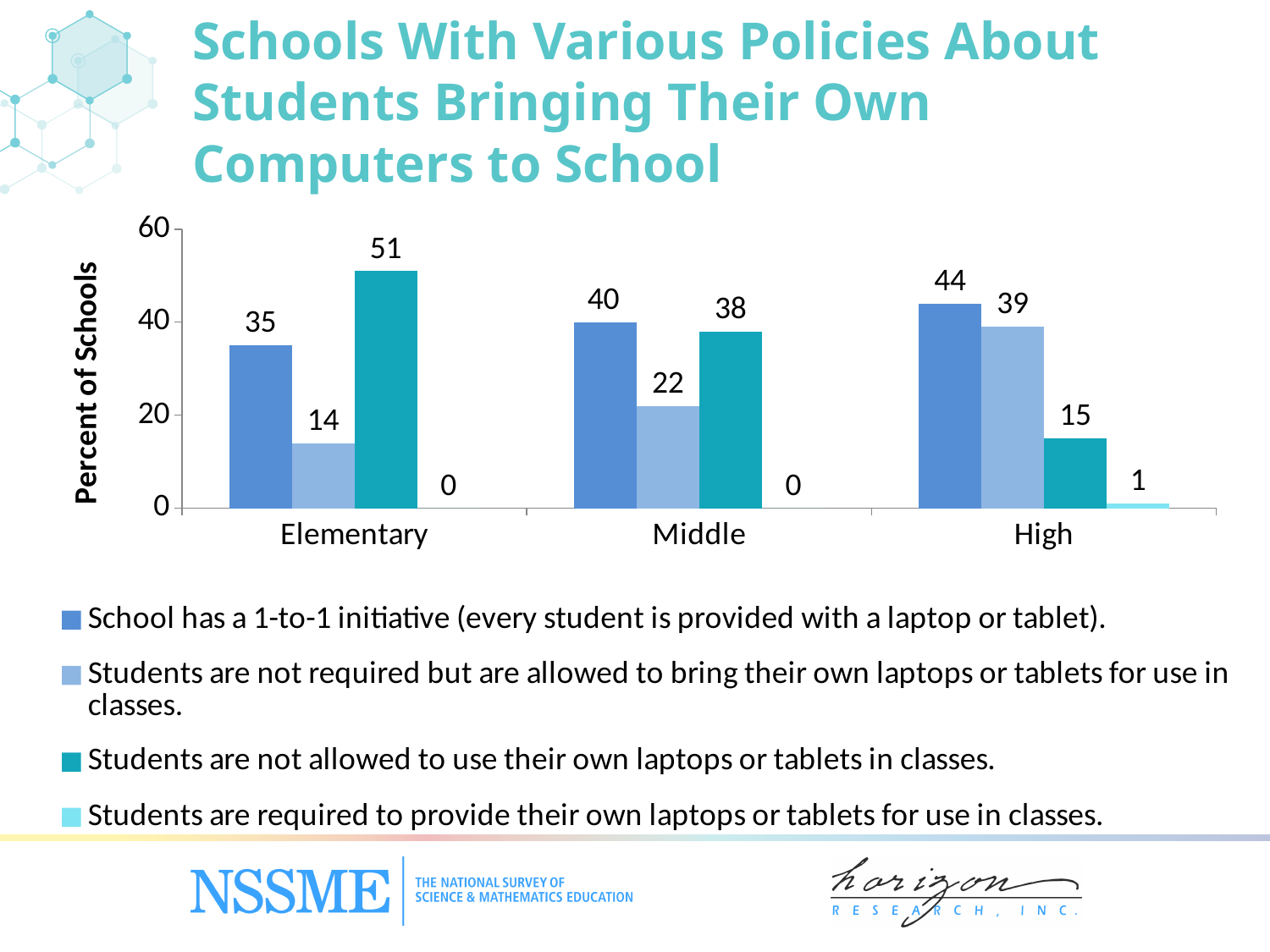
Which is larger: the percentage of middle schools with a 1-to-1 initiative or the percentage of middle schools that do not allow students' own laptops or tablets? 1-to-1 initiative (40) Which school level has the highest percentage of schools that do not allow students to use their own laptops or tablets in classes? Elementary What percent of middle schools allow but do not require students to bring their own laptops or tablets? 22 What kind of chart is shown on the slide? Bar chart What percent of elementary schools have a 1-to-1 initiative? 35 What percent of high schools require students to provide their own laptops or tablets for use in classes? 1 What percent of high schools do not allow students to use their own laptops or tablets in classes? 15 How many school levels are shown on the x axis? 3 What is the label of the y axis? Percent of Schools What is the difference between the percentage of high schools and elementary schools that allow but do not require students to bring their own laptops or tablets? 25 How many series does the legend list? 4 Which school level has the lowest percentage of schools with a 1-to-1 initiative? Elementary